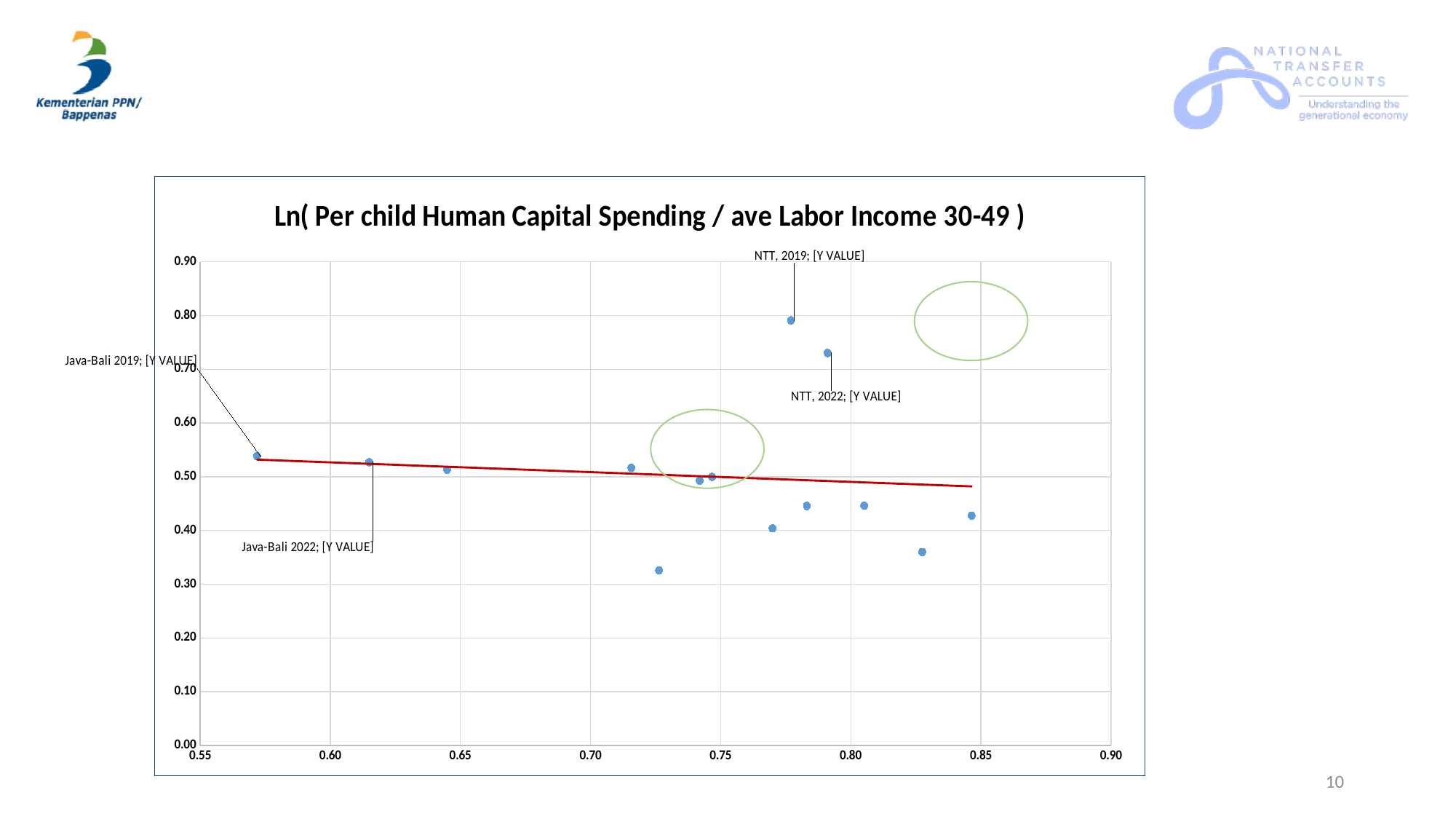
Which has a higher y value, NTT, 2022 or Java-Bali 2022? NTT, 2022 Which labeled point has the lowest y value? Java-Bali 2022 Which has a higher y value, NTT, 2019 or Java-Bali 2019? NTT, 2019 Is the y value for Java-Bali 2022 greater or less than 0.60? less Is the y value for NTT, 2022 greater or less than 0.80? less What is the maximum value shown on the y axis? 0.90 Is the y value for Java-Bali 2019 greater or less than 0.50? greater Does the red trend line rise or fall as the x value increases? fall What is the title of the chart? Ln( Per child Human Capital Spending / ave Labor Income 30-49 ) What kind of chart is shown on the slide? scatter chart Which labeled point has the highest y value? NTT, 2019